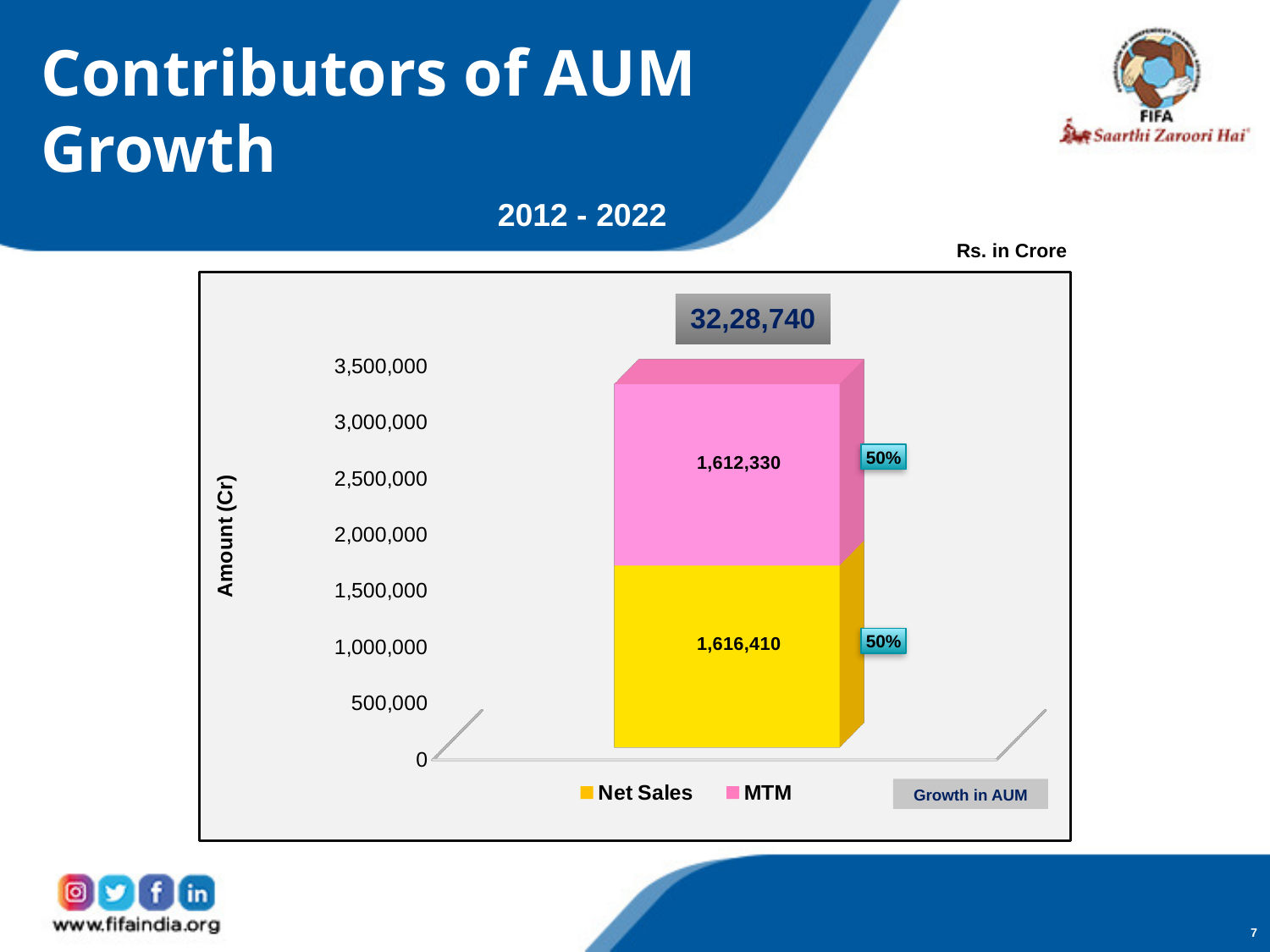
What percentage share of the growth in AUM is attributed to MTM? 50% What is the label of the vertical axis? Amount (Cr) What is the total shown at the top of the stacked bar? 32,28,740 What is the value of MTM in the stacked bar? 1,612,330 Which is larger, Net Sales or MTM? Net Sales What is the value of Net Sales in the stacked bar? 1,616,410 What percentage share of the growth in AUM is attributed to Net Sales? 50% What kind of chart is shown on the slide? stacked bar chart Which colour represents MTM in the chart? pink Is the value for Net Sales greater or less than 1,500,000? greater How many series does the legend list? 2 What is the difference between the Net Sales value and the MTM value? 4,080